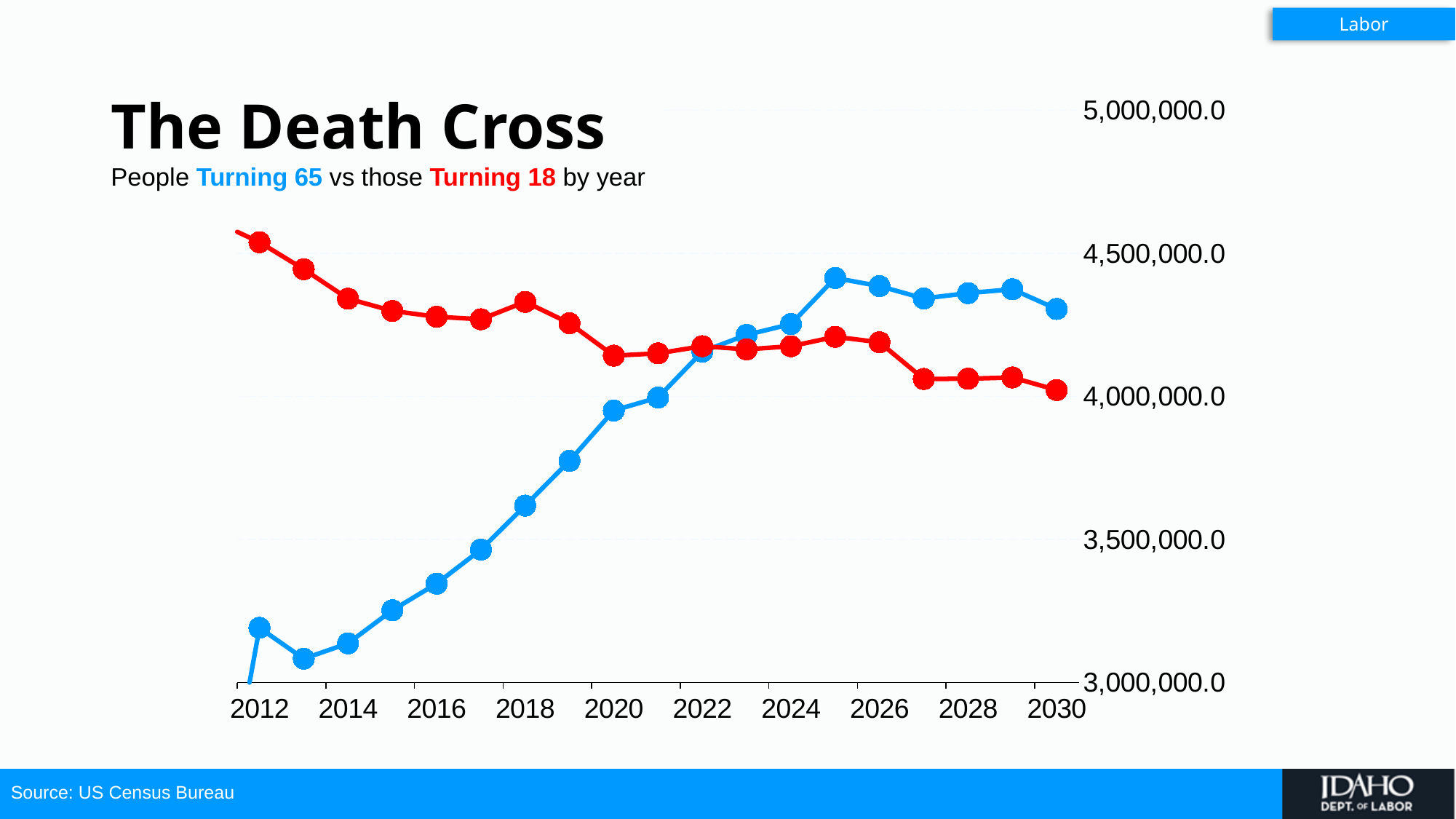
What kind of chart is shown on the slide? Line chart How many series does the chart plot? 2 Does the Turning 65 line rise or fall overall from 2012 to 2030? Rise Is the value for Turning 65 in 2030 greater or less than 4,000,000.0? greater Is the value for Turning 65 in 2012 greater or less than 3,500,000.0? less Does the Turning 18 line rise or fall overall from 2012 to 2030? Fall What is the title of the chart? The Death Cross In 2012, which series has the higher value, Turning 65 or Turning 18? Turning 18 Which colour is used for the Turning 65 line? Blue Is the value for Turning 18 in 2012 greater or less than 4,500,000.0? greater In which year does the Turning 65 line reach its highest value? 2025 In 2030, which series has the higher value, Turning 65 or Turning 18? Turning 65